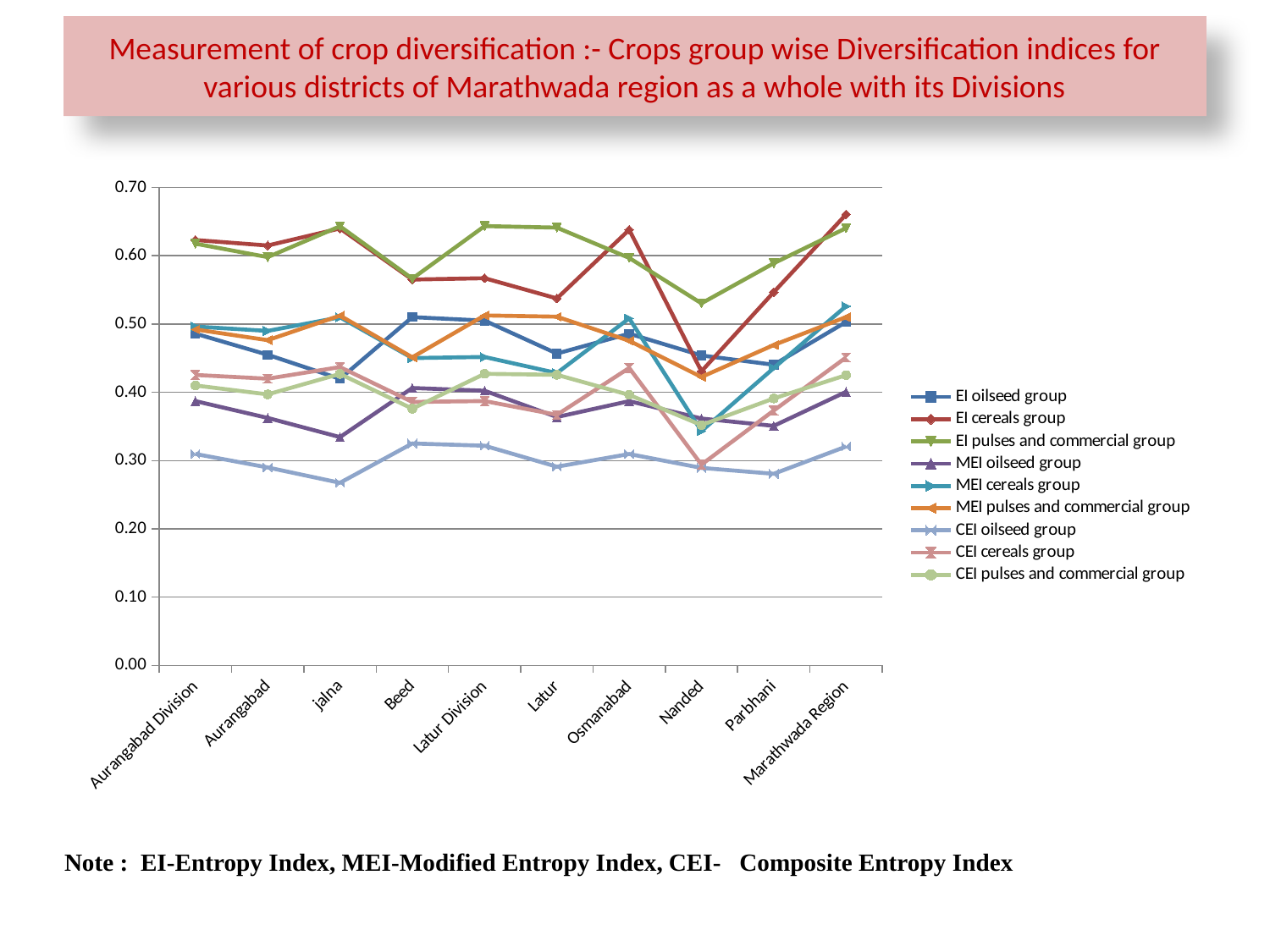
Which series has the lowest value at Aurangabad Division? CEI oilseed group Is the value for EI pulses and commercial group at Jalna greater or less than 0.60? greater Is the value for MEI oilseed group at Jalna greater or less than 0.40? less Is the value for CEI oilseed group at Jalna greater or less than 0.30? less What kind of chart is shown on the slide? line chart How many series does the legend list? 9 According to the note on the slide, what does CEI stand for? Composite Entropy Index At Nanded, which is larger: EI pulses and commercial group or EI cereals group? EI pulses and commercial group Does the CEI oilseed group line rise or fall from Aurangabad Division to Jalna? fall For which category is the EI cereals group value lowest? Nanded How many categories are shown along the x axis? 10